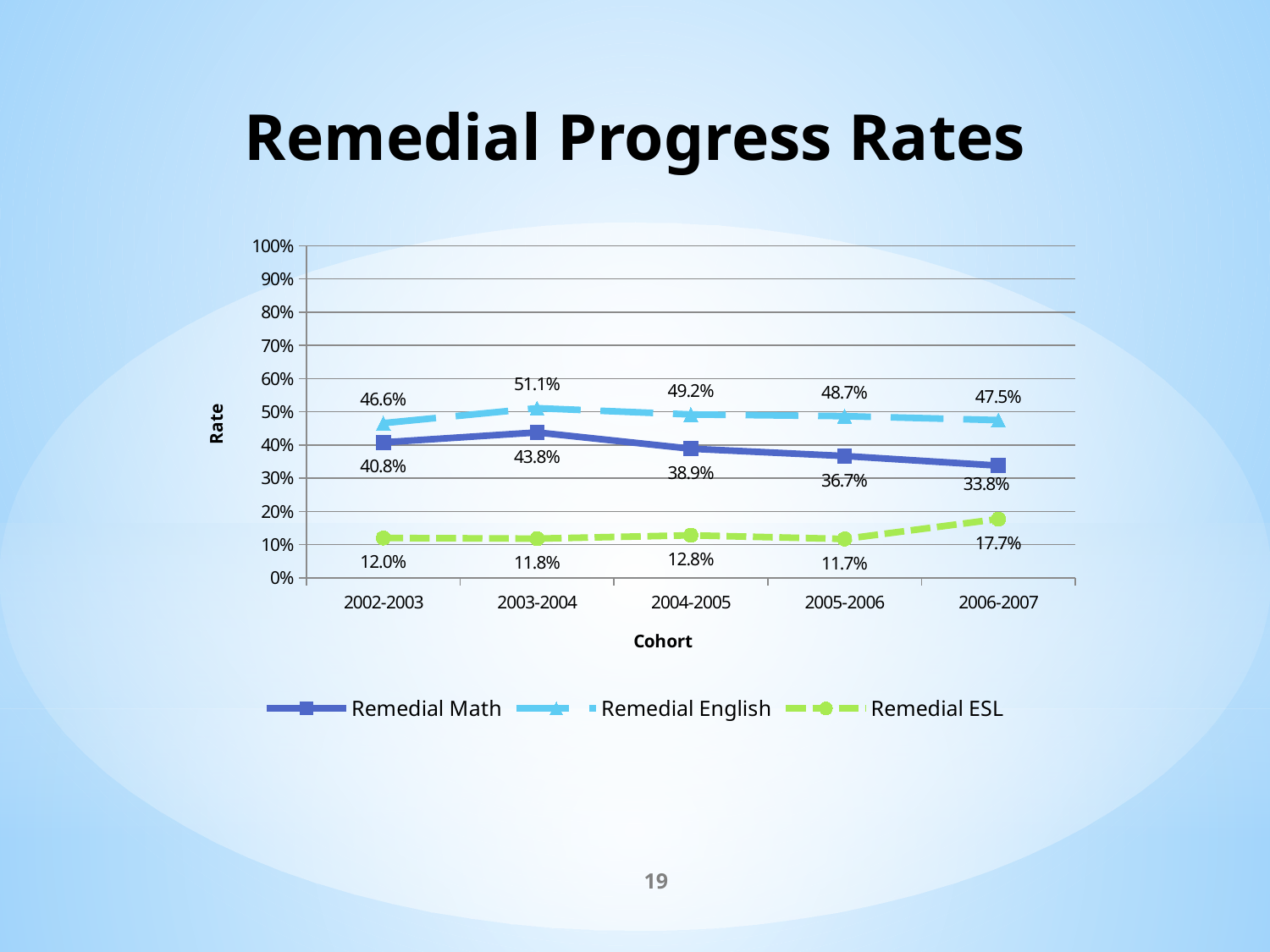
Is the Remedial English rate for the 2004-2005 cohort greater or less than 40%? greater Which is larger for the 2006-2007 cohort, the Remedial ESL rate or the Remedial Math rate? Remedial Math What is the Remedial English rate for the 2006-2007 cohort? 47.5% What is the Remedial Math rate for the 2003-2004 cohort? 43.8% How many series does the legend list? 3 What is the Remedial ESL rate for the 2005-2006 cohort? 11.7% Which cohort has the highest Remedial English rate? 2003-2004 Which cohort has the lowest Remedial Math rate? 2006-2007 Does the Remedial Math rate rise or fall from the 2003-2004 cohort to the 2006-2007 cohort? Fall What kind of chart is shown on the slide? Line chart What is the difference between the Remedial English and Remedial Math rates for the 2002-2003 cohort? 5.8% How many cohorts are shown on the x axis? 5